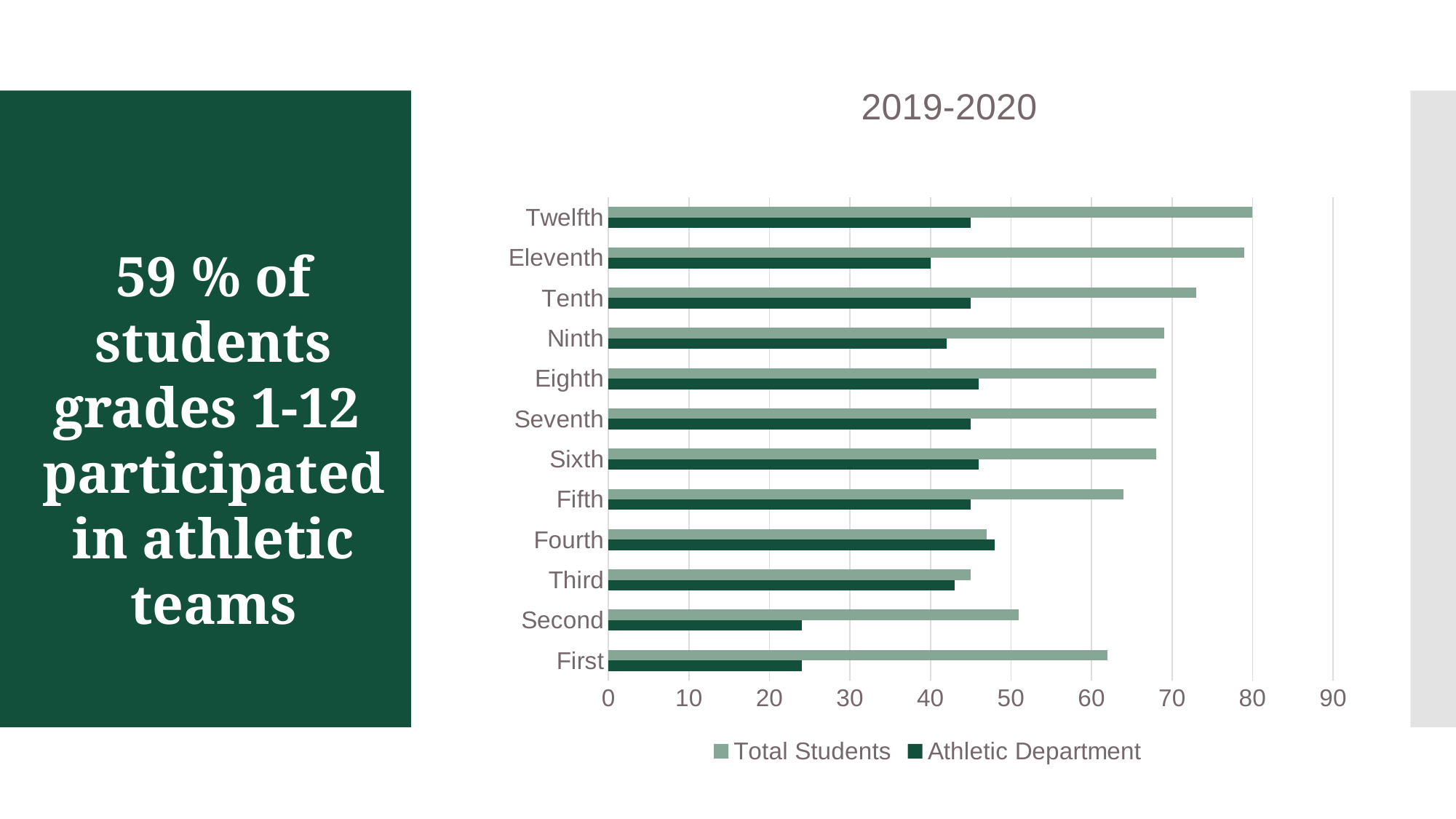
Is the Athletic Department value for Ninth grade greater or less than 40? greater How many series does the legend list? 2 Is the Total Students value for First grade greater or less than 60? greater Which is larger, the Athletic Department value for Second grade or for Third grade? Third Is the Total Students value for Tenth grade greater or less than 70? greater What kind of chart is shown on the slide? bar chart Which is larger, the Total Students value for Twelfth grade or for Second grade? Twelfth What is the title of the chart? 2019-2020 How many grade categories are plotted on the chart? 12 What are the two series named in the legend? Total Students and Athletic Department